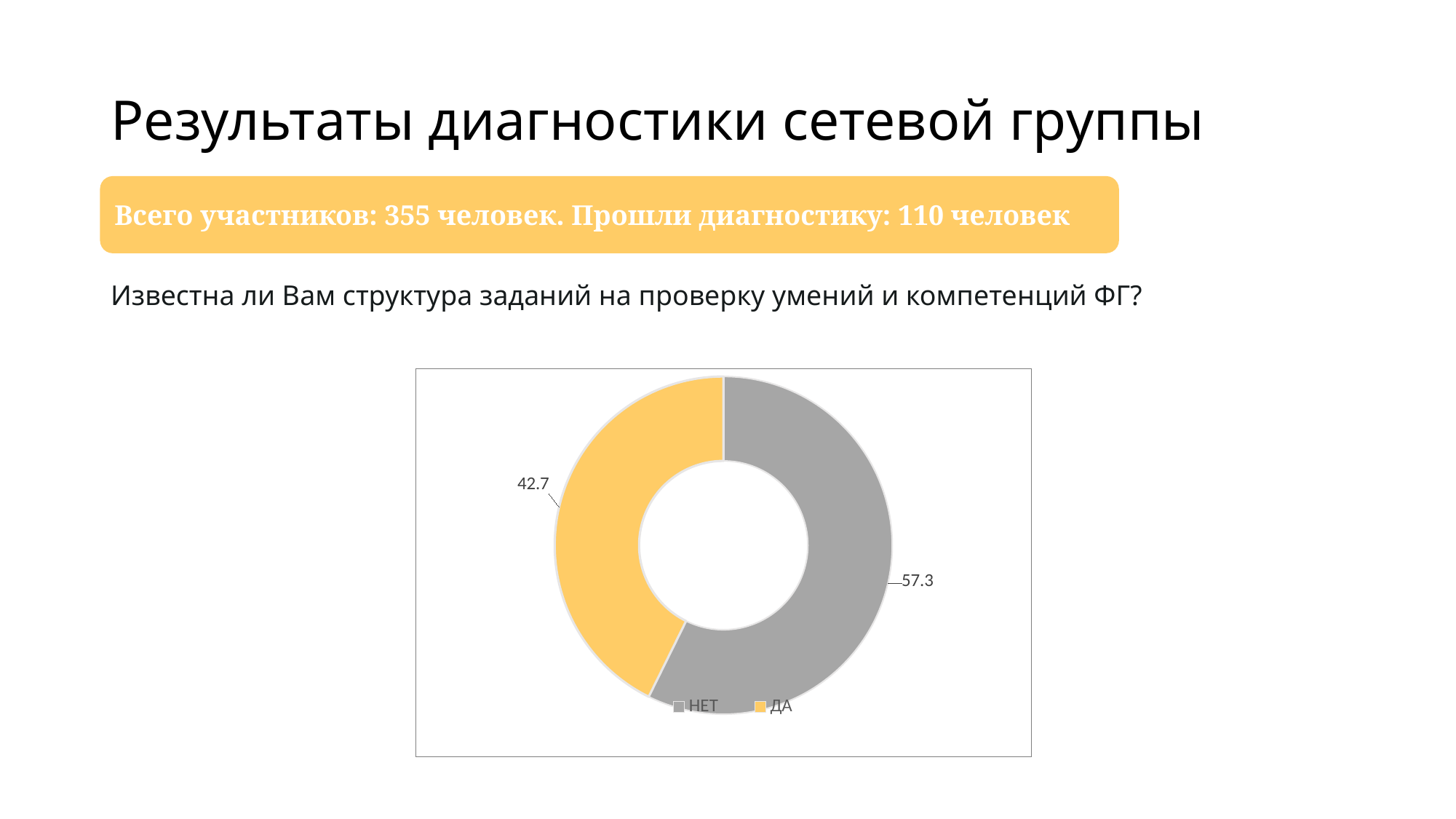
How many slices does the chart have? 2 What kind of chart is shown on the slide? Doughnut (pie) chart What colour is the ДА slice? Yellow Which slice is the largest? НЕТ What colour is the НЕТ slice? Grey How many entries does the legend list? 2 What value is shown for the ДА slice? 42.7 What is the difference between the НЕТ and ДА values? 14.6 What value is shown for the НЕТ slice? 57.3 What is the total of the two slice values? 100 Which slice is the smallest? ДА Which is larger, the value for ДА or the value for НЕТ? НЕТ